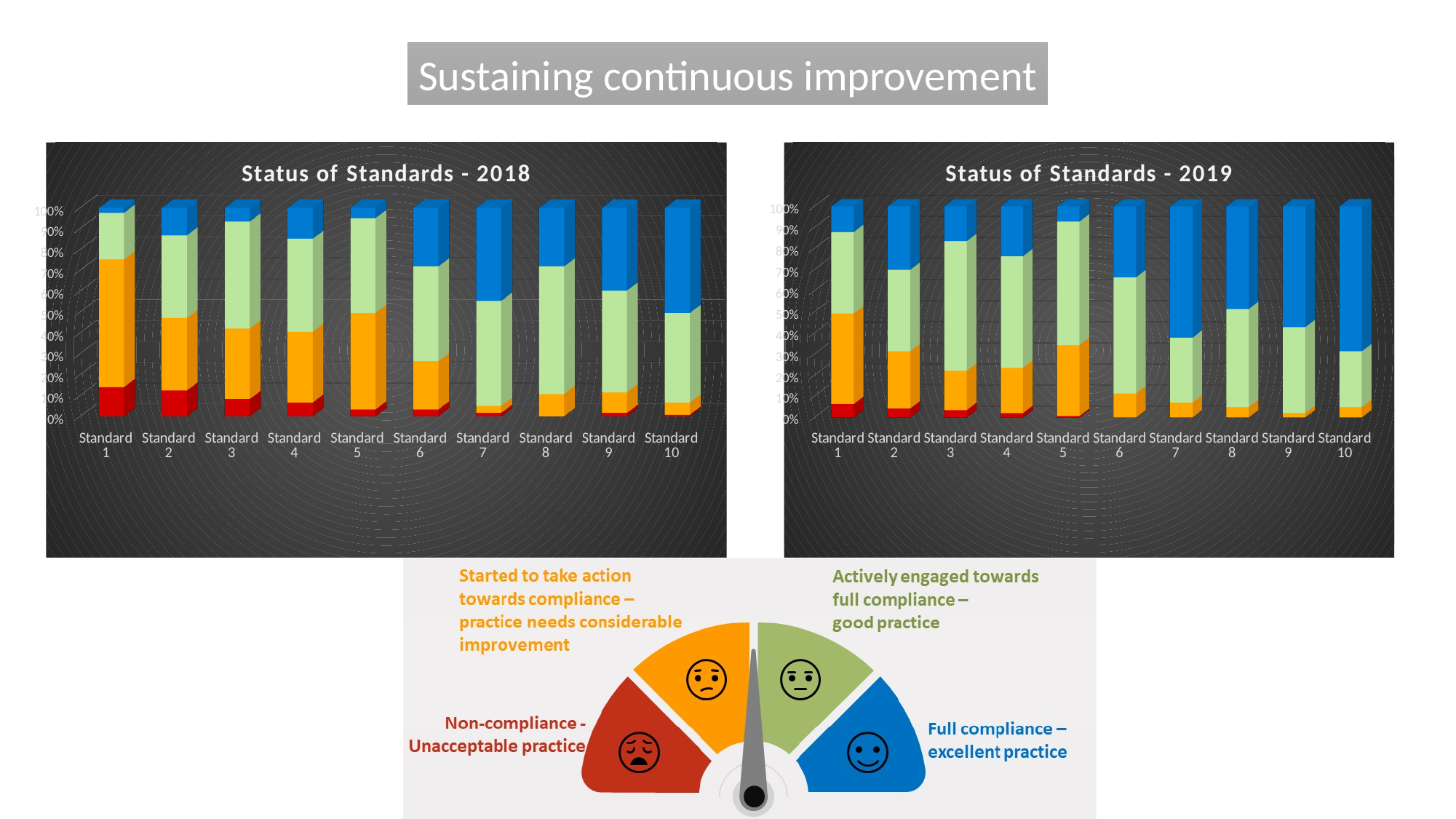
In the 'Status of Standards - 2019' chart, which standard has the largest blue segment? Standard 10 In the 'Status of Standards - 2018' chart, is the orange segment for Standard 1 greater or less than 50%? greater What is the highest value shown on the vertical axis of the 'Status of Standards - 2019' chart? 100% Is the blue segment for Standard 10 larger in the 'Status of Standards - 2018' chart or in the 'Status of Standards - 2019' chart? Status of Standards - 2019 What is the title of the chart on the left of the slide? Status of Standards - 2018 What kind of chart is the 'Status of Standards - 2018' chart? Stacked bar chart In the 'Status of Standards - 2019' chart, is the blue segment for Standard 5 greater or less than 20%? less In the 'Status of Standards - 2019' chart, is the blue segment for Standard 10 greater or less than 50%? greater How many standards are shown on the x axis of the 'Status of Standards - 2019' chart? 10 In the 'Status of Standards - 2018' chart, which standard has the largest orange segment? Standard 1 In the 'Status of Standards - 2018' chart, is the red segment for Standard 1 larger or smaller than the red segment for Standard 10? larger